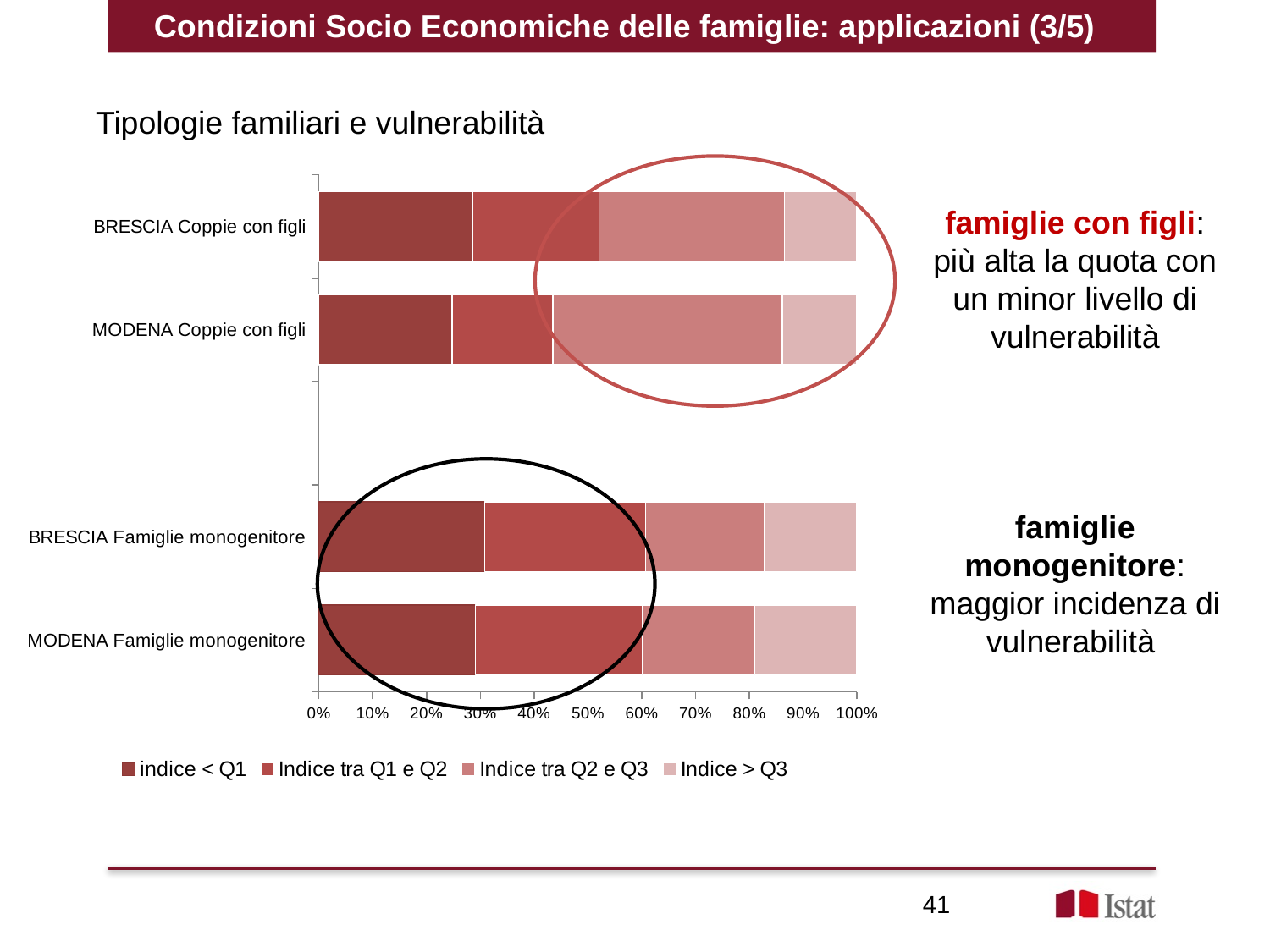
What kind of chart is shown on the slide? Stacked bar chart How many family-type categories are plotted on the chart? 4 Is the 'Indice tra Q2 e Q3' segment for MODENA Coppie con figli greater or less than 30%? greater Is the 'Indice tra Q1 e Q2' segment for BRESCIA Famiglie monogenitore greater or less than 20%? greater Which category has the largest 'Indice tra Q2 e Q3' segment? MODENA Coppie con figli Which legend entry is shown with the darkest colour? indice < Q1 Which category has the smallest 'indice < Q1' segment? MODENA Coppie con figli What is the total of each stacked bar, as read from the axis where the bars end? 100% What is the title shown above the chart? Tipologie familiari e vulnerabilità How many series does the chart legend list? 4 Which is larger: the 'Indice tra Q1 e Q2' segment for MODENA Coppie con figli or for BRESCIA Famiglie monogenitore? BRESCIA Famiglie monogenitore Is the 'indice < Q1' segment for MODENA Coppie con figli greater or less than 30%? less